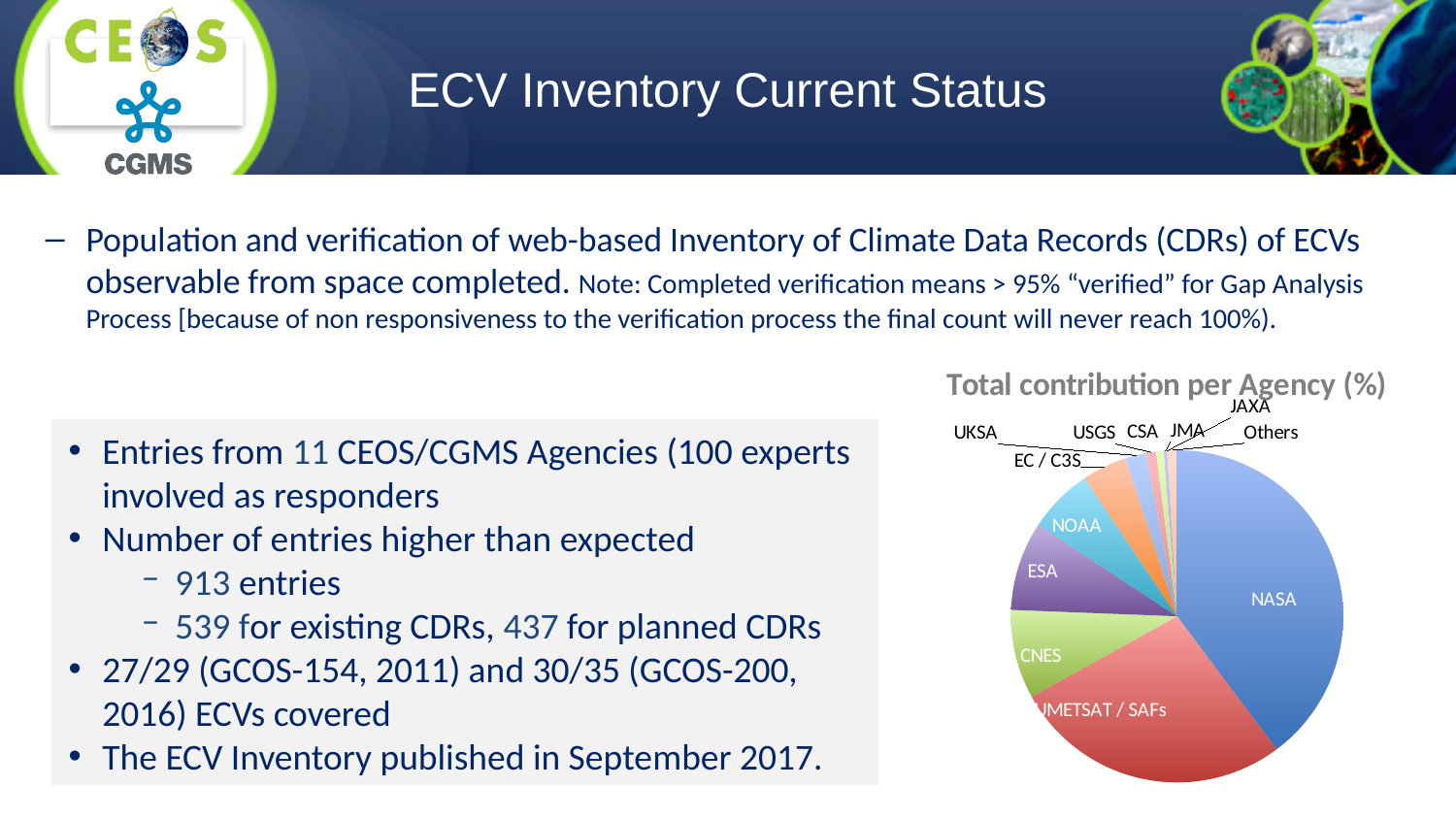
Which agency has the second largest slice in the pie chart? EUMETSAT / SAFs Which agency has the largest slice in the pie chart? NASA Which slice is larger in the pie chart, EC / C3S or NASA? NASA What colour is the NASA slice in the pie chart? blue How many slices does the pie chart have? 12 Which slice is larger in the pie chart, NOAA or USGS? NOAA Which slice is larger in the pie chart, ESA or NOAA? ESA What is the title of the chart on the slide? Total contribution per Agency (%) What kind of chart is shown on the slide? pie chart